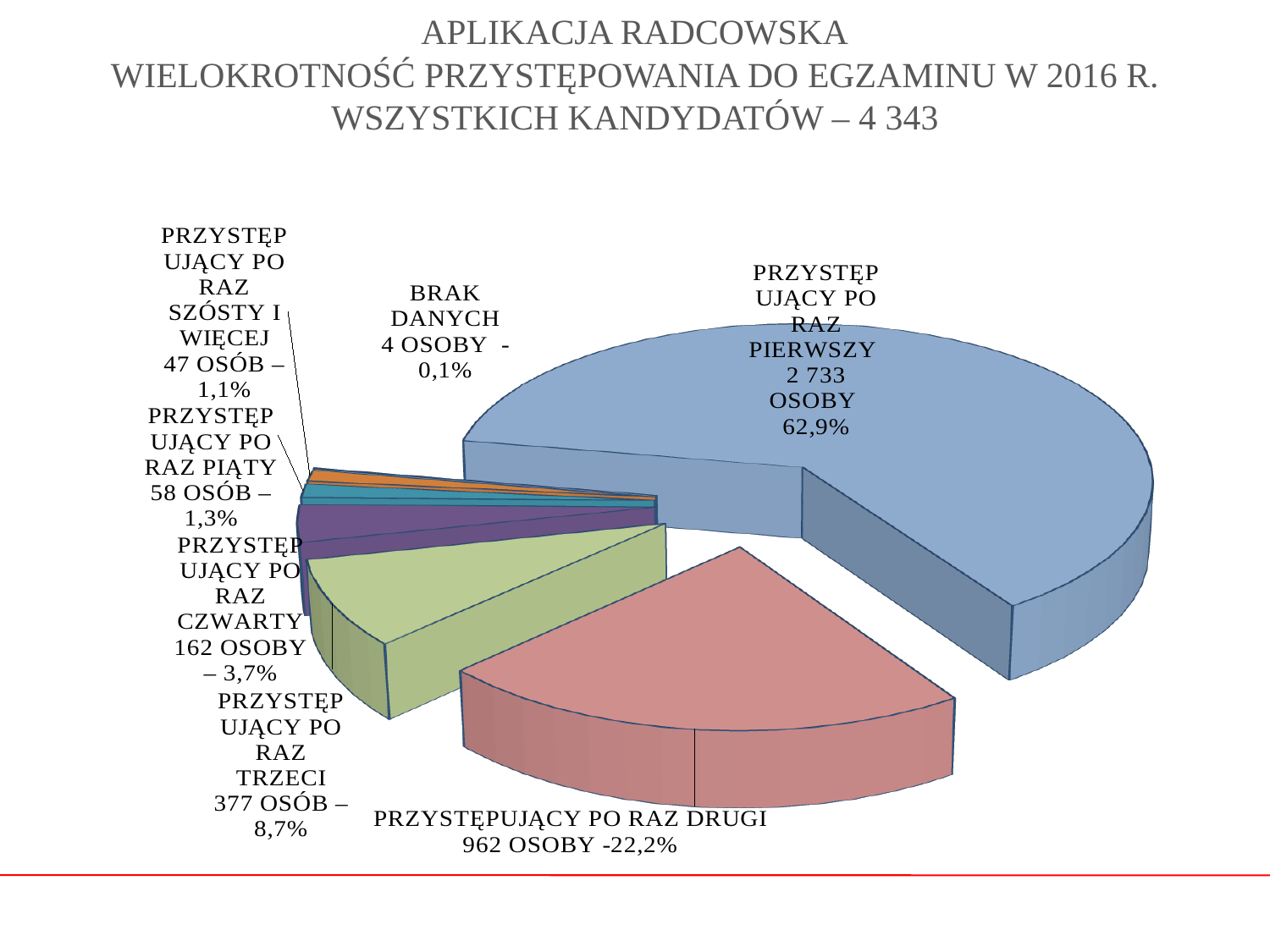
How many people are in the BRAK DANYCH category? 4 How many people are in the PRZYSTĘPUJĄCY PO RAZ TRZECI category? 377 How many candidates took the exam for the first time (PRZYSTĘPUJĄCY PO RAZ PIERWSZY)? 2 733 Which category has the smallest slice of the pie? BRAK DANYCH What is the difference in number of people between PRZYSTĘPUJĄCY PO RAZ PIERWSZY and PRZYSTĘPUJĄCY PO RAZ DRUGI? 1 771 What percentage is shown for PRZYSTĘPUJĄCY PO RAZ CZWARTY? 3,7% Which category has more people: PRZYSTĘPUJĄCY PO RAZ PIĄTY or PRZYSTĘPUJĄCY PO RAZ SZÓSTY I WIĘCEJ? PRZYSTĘPUJĄCY PO RAZ PIĄTY What total number of candidates is given in the chart title? 4 343 Which category has the largest slice of the pie? PRZYSTĘPUJĄCY PO RAZ PIERWSZY What share of the pie is taken by candidates sitting the exam for the second time (PRZYSTĘPUJĄCY PO RAZ DRUGI)? 22,2% What kind of chart is shown on the slide? pie chart How many slices does the pie chart have? 7